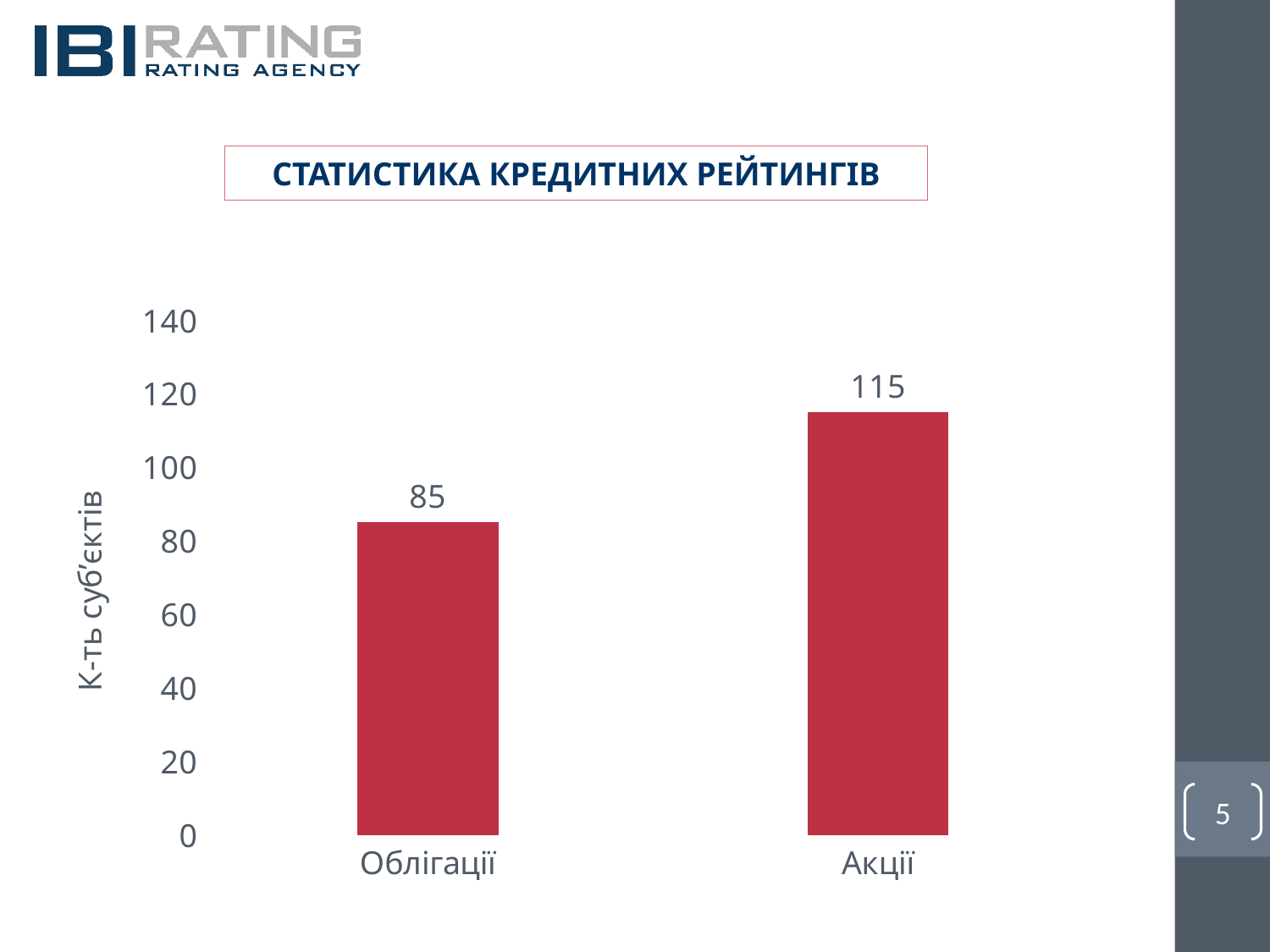
What is the label of the vertical axis? К-ть суб'єктів What is the value for Акції? 115 What kind of chart is shown on the slide? bar chart Which category has the lowest value? Облігації How many categories are shown on the chart? 2 What is the title of the chart? СТАТИСТИКА КРЕДИТНИХ РЕЙТИНГІВ Which category has the highest value? Акції Is the value for Акції greater or less than 100? greater What is the difference between the values for Акції and Облігації? 30 Which is larger, the value for Облігації or the value for Акції? Акції What is the value for Облігації? 85 Is the value for Облігації greater or less than 100? less